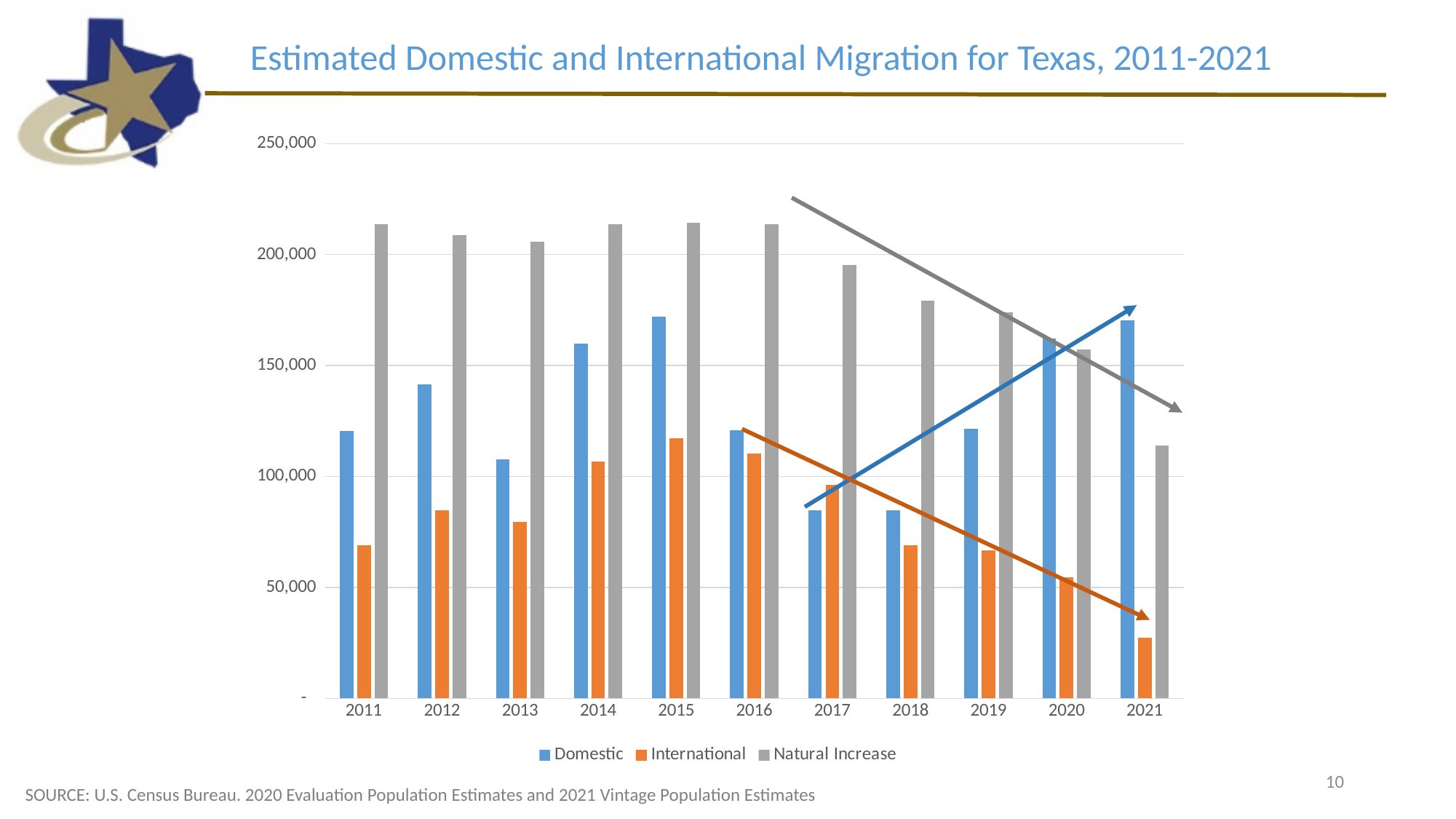
Which year has the highest International value? 2015 Is the Natural Increase value for 2011 greater or less than 200,000? greater Is the Domestic value for 2015 greater or less than 150,000? greater Do the Natural Increase values rise or fall from 2016 to 2021? fall Which is larger in 2014, the Domestic value or the International value? Domestic What kind of chart is shown on the slide? Bar chart Which year has the lowest Natural Increase value? 2021 Which year has the lowest International value? 2021 How many series does the legend list? 3 Is the International value for 2021 greater or less than 50,000? less How many years are shown on the x axis? 11